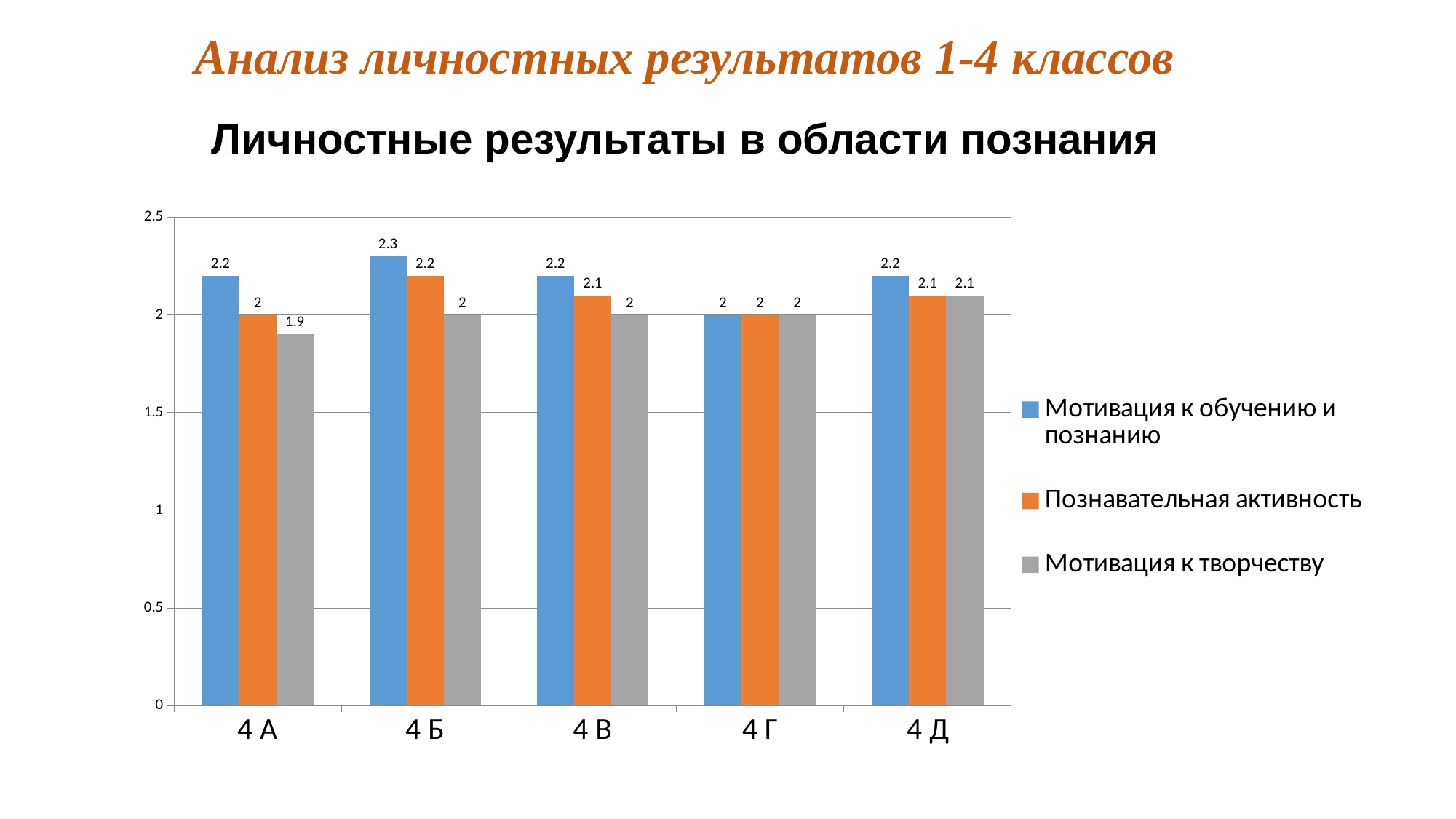
What is the value of Познавательная активность for 4 Г? 2 What kind of chart is shown on the slide? Bar chart What is the value of Мотивация к обучению и познанию for 4 Б? 2.3 What is the difference between Мотивация к обучению и познанию and Мотивация к творчеству for 4 А? 0.3 Which colour represents Познавательная активность in the legend? Orange How many series does the legend list? 3 Which is larger for 4 Б: Мотивация к обучению и познанию or Познавательная активность? Мотивация к обучению и познанию What is the value of Познавательная активность for 4 В? 2.1 How many classes are shown on the x axis? 5 What is the value of Мотивация к творчеству for 4 А? 1.9 Which class has the highest value for Мотивация к обучению и познанию? 4 Б Which class has the lowest value for Мотивация к творчеству? 4 А